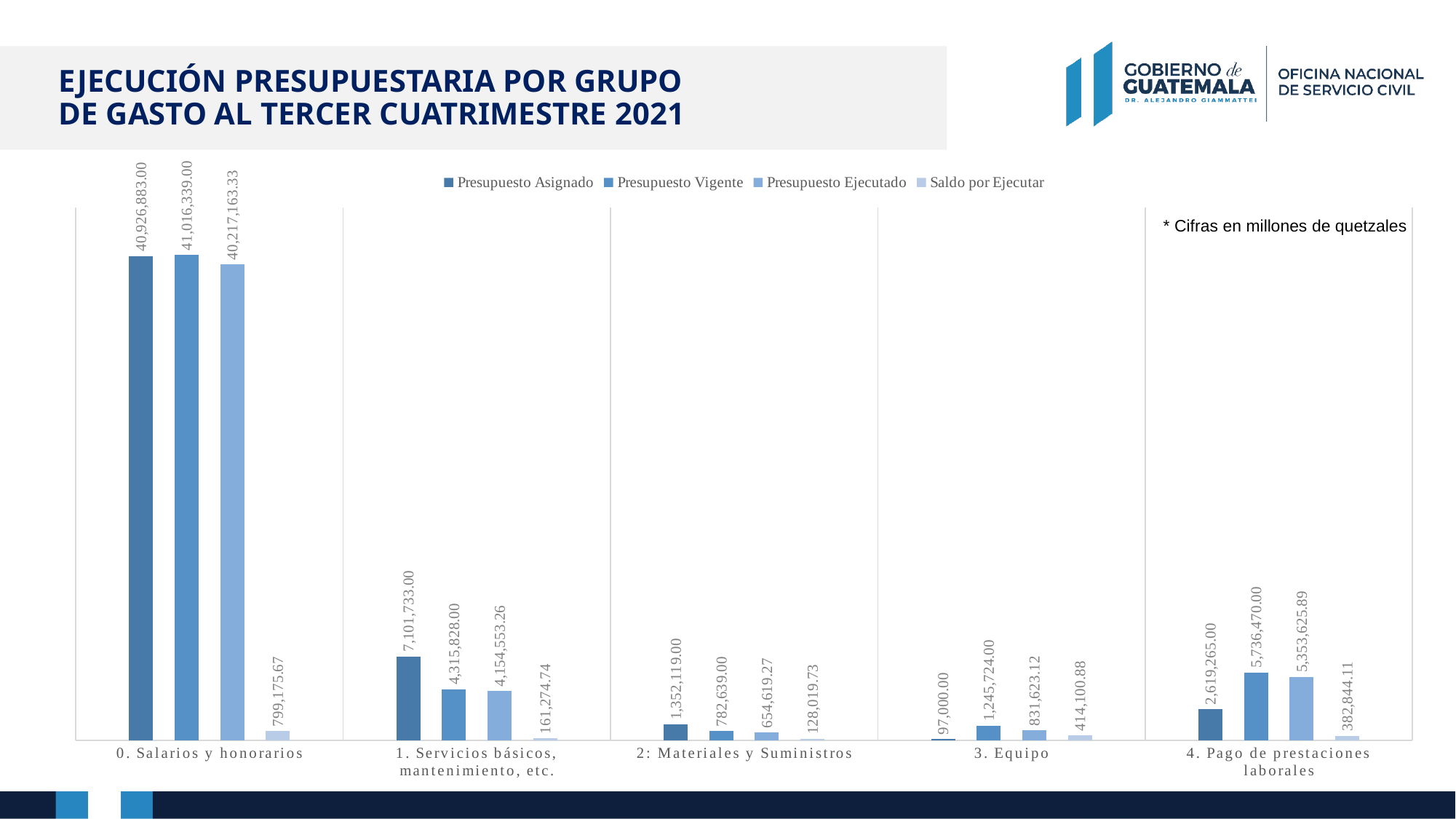
How many categories are shown on the x axis? 5 What is the Presupuesto Asignado value for 3. Equipo? 97,000.00 Which category has the lowest Presupuesto Asignado? 3. Equipo What is the Saldo por Ejecutar value for 2: Materiales y Suministros? 128,019.73 What is the difference between Presupuesto Vigente and Presupuesto Asignado for 3. Equipo? 1,148,724.00 How many series does the legend list? 4 Which is larger for 1. Servicios básicos, mantenimiento, etc.: Presupuesto Asignado or Presupuesto Vigente? Presupuesto Asignado What is the Presupuesto Ejecutado value for 4. Pago de prestaciones laborales? 5,353,625.89 What is the difference between Presupuesto Vigente and Presupuesto Ejecutado for 0. Salarios y honorarios? 799,175.67 Which category has the highest Presupuesto Ejecutado? 0. Salarios y honorarios What is the Presupuesto Vigente value for 0. Salarios y honorarios? 41,016,339.00 What kind of chart is shown on the slide? Bar chart